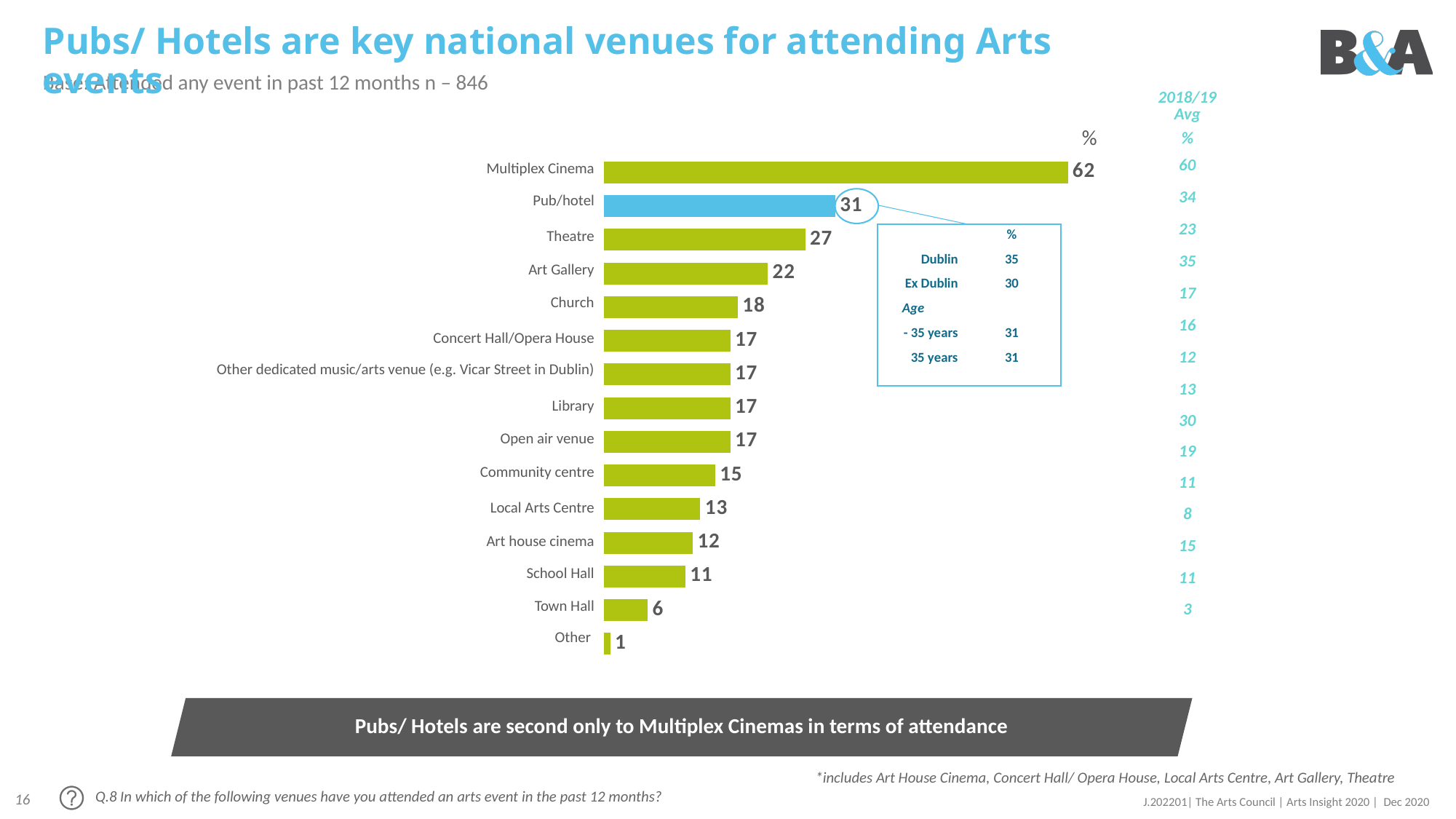
What is the difference between the values for Multiplex Cinema and Pub/hotel? 31 What kind of chart is shown on the slide? bar chart What is the value for Church? 18 What is the value for Town Hall? 6 What is the value for Pub/hotel? 31 Which is larger, the value for Theatre or the value for Art Gallery? Theatre Which venue has the highest value? Multiplex Cinema Which bar in the chart is coloured blue rather than green? Pub/hotel How many venue categories are plotted in the chart? 15 Which venue has the lowest value? Other In the callout box for Pub/hotel, what is the value for Dublin? 35 What is the value for Multiplex Cinema? 62